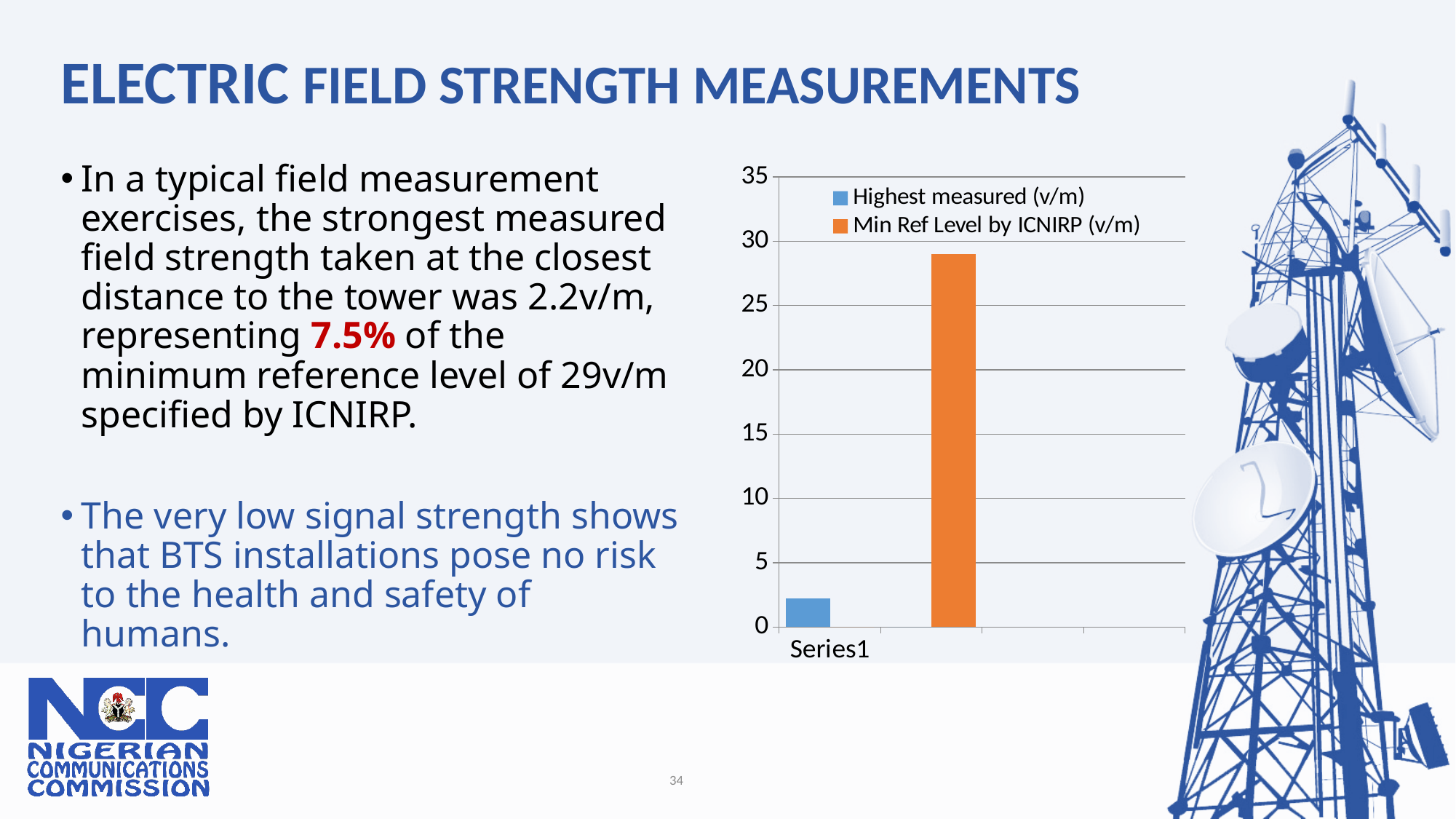
Is the value for Highest measured (v/m) greater or less than 5? less How many series does the chart legend list? 2 Is the value for Min Ref Level by ICNIRP (v/m) greater or less than 25? greater How many categories are shown on the x axis of the chart? 1 Which series has the lowest bar in the chart? Highest measured (v/m) Which series has the taller bar, Highest measured (v/m) or Min Ref Level by ICNIRP (v/m)? Min Ref Level by ICNIRP (v/m) What colour is the bar for Min Ref Level by ICNIRP (v/m)? orange What is the label of the category on the x axis? Series1 Which series has the highest bar in the chart? Min Ref Level by ICNIRP (v/m) What kind of chart is shown on the slide? bar chart Is the value for Min Ref Level by ICNIRP (v/m) greater or less than 30? less What is the highest value shown on the y axis of the chart? 35